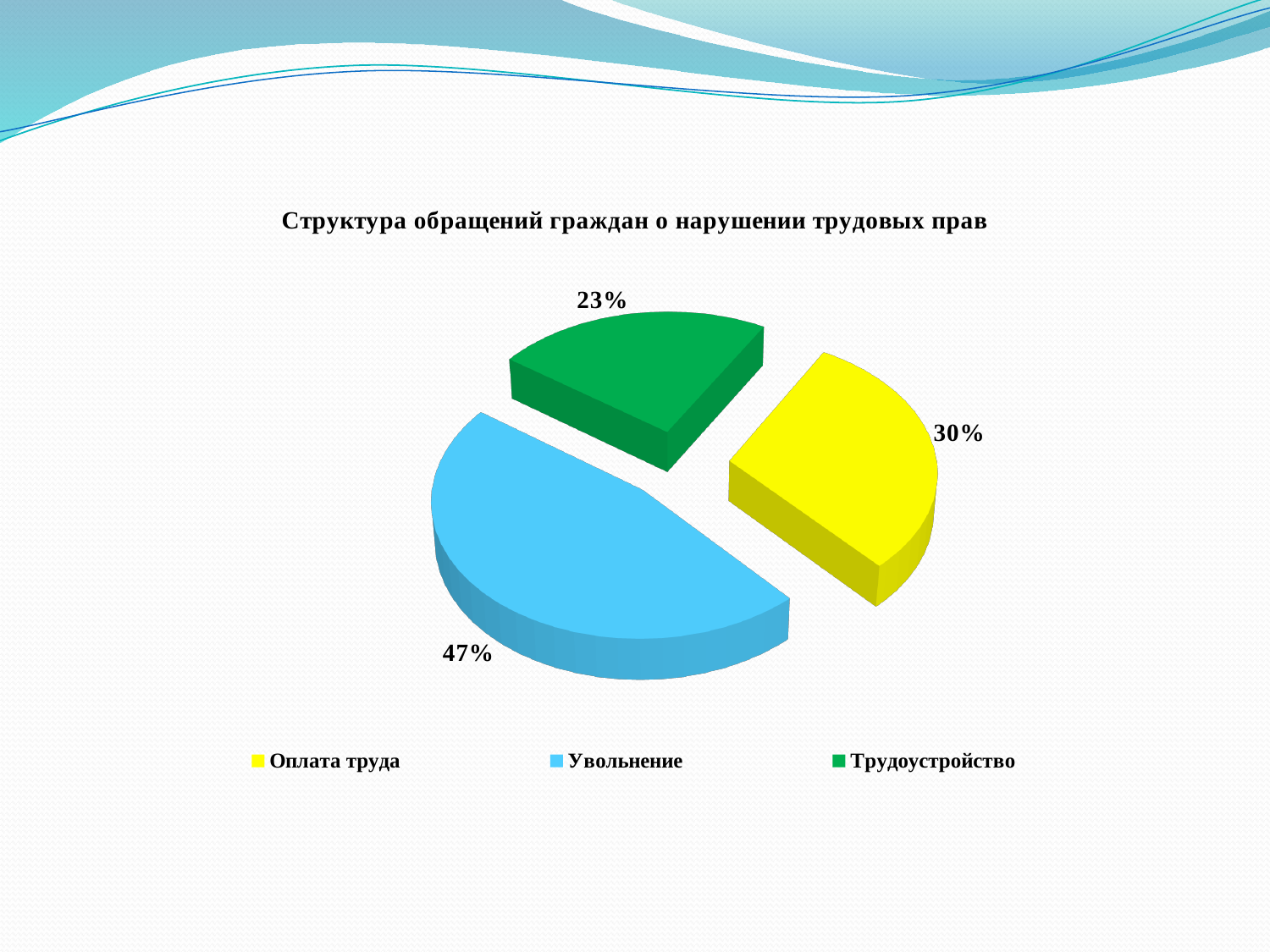
What is the title of the chart? Структура обращений граждан о нарушении трудовых прав What share of the pie does Трудоустройство have? 23% What is the difference in percentage points between Оплата труда and Трудоустройство? 7 Which category has the largest share of the pie? Увольнение What colour is the slice for Трудоустройство? Green What share of the pie does Оплата труда have? 30% Which category has the smallest share of the pie? Трудоустройство What share of the pie does Увольнение have? 47% Which is larger, the share for Оплата труда or the share for Трудоустройство? Оплата труда How many slices does the pie chart have? 3 What is the difference in percentage points between Увольнение and Оплата труда? 17 What kind of chart is shown on the slide? Pie chart